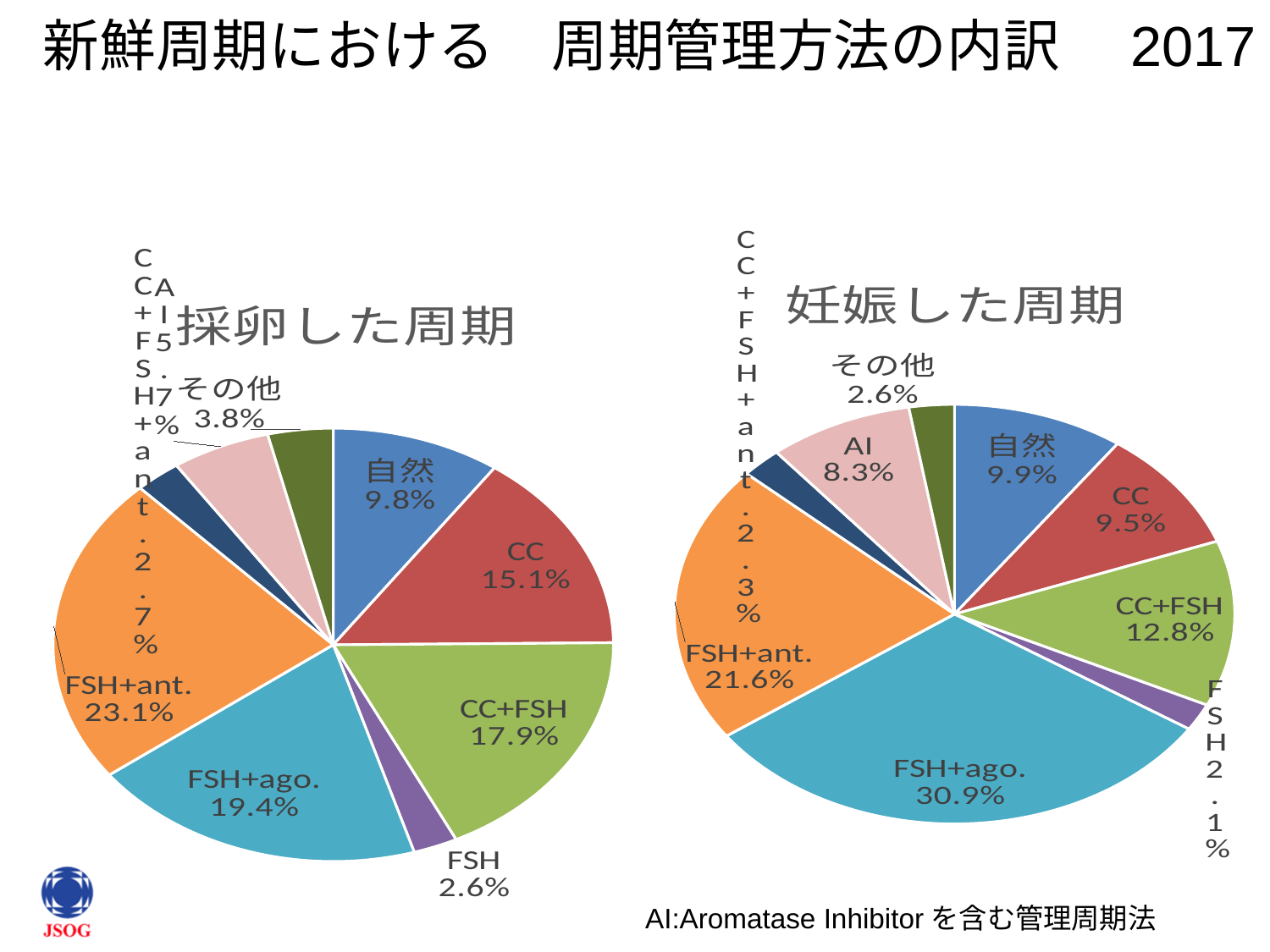
In the left pie chart (採卵した周期), which is larger, CC or CC+FSH? CC+FSH In the left pie chart (採卵した周期), what is the share for 自然? 9.8% What kind of chart is used on this slide? Pie chart In the right pie chart (妊娠した周期), what is the share for AI? 8.3% In the left pie chart (採卵した周期), which category has the largest share? FSH+ant. In the left pie chart (採卵した周期), what is the difference in percentage points between FSH+ant. and FSH+ago.? 3.7 In the left pie chart (採卵した周期), what is the share for FSH+ant.? 23.1% In the right pie chart (妊娠した周期), what is the difference in percentage points between FSH+ago. and FSH+ant.? 9.3 What is the title of the right chart? 妊娠した周期 In the right pie chart (妊娠した周期), which is larger, 自然 or CC? 自然 In the right pie chart (妊娠した周期), what is the share for CC+FSH? 12.8% In the right pie chart (妊娠した周期), which category has the largest share? FSH+ago.